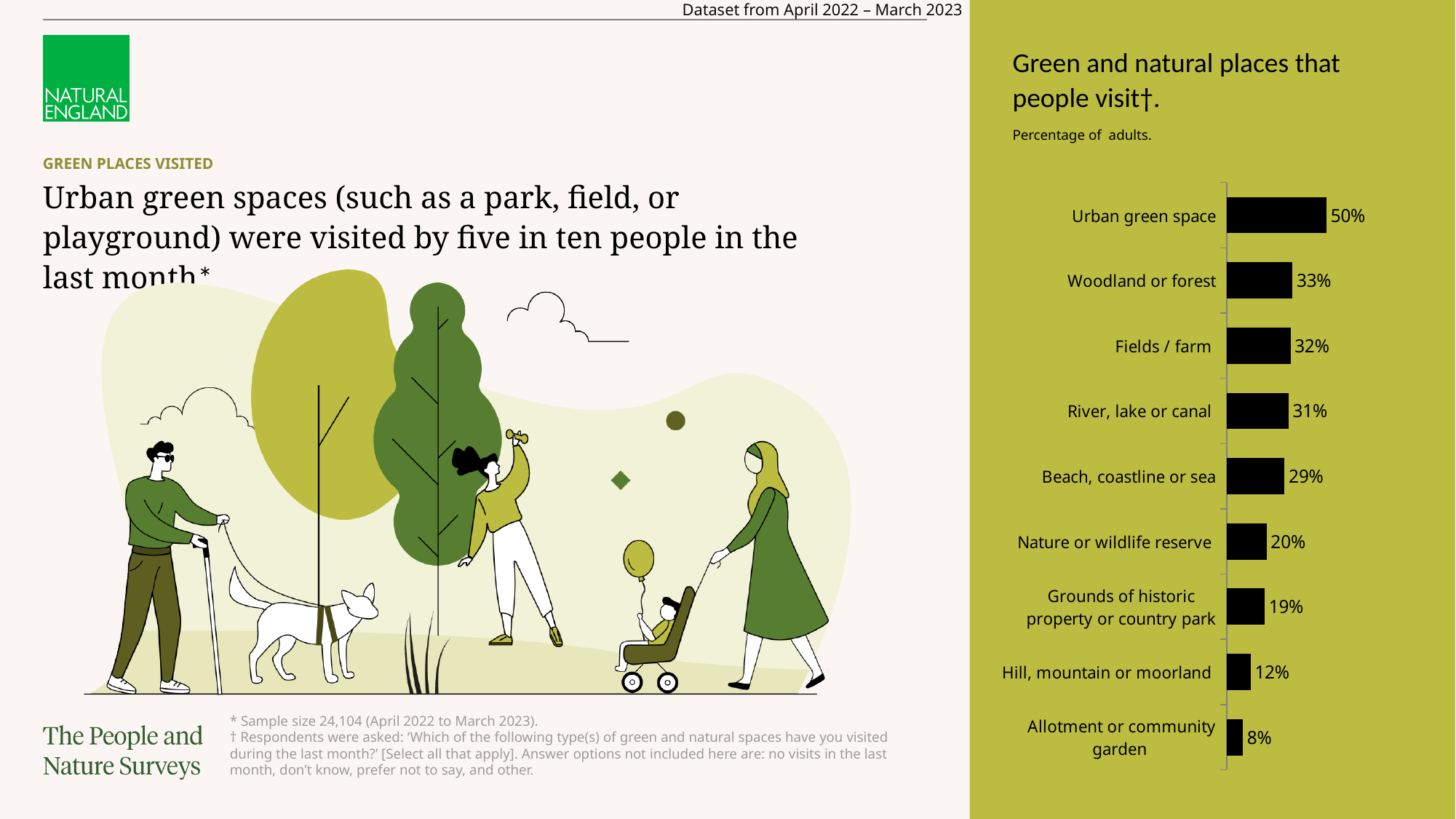
How many categories are shown in the chart? 9 What percentage of adults visited an urban green space? 50% Which category has the lowest percentage? Allotment or community garden What kind of chart is shown on the slide? Bar chart What is the difference between Urban green space and Woodland or forest? 17% What is the value for Beach, coastline or sea? 29% What percentage of adults visited a hill, mountain or moorland? 12% Which is larger: Beach, coastline or sea or Nature or wildlife reserve? Beach, coastline or sea What is the value for Grounds of historic property or country park? 19% What is the difference between Nature or wildlife reserve and Allotment or community garden? 12% What is the title of the chart? Green and natural places that people visit†. Which category has the highest percentage? Urban green space